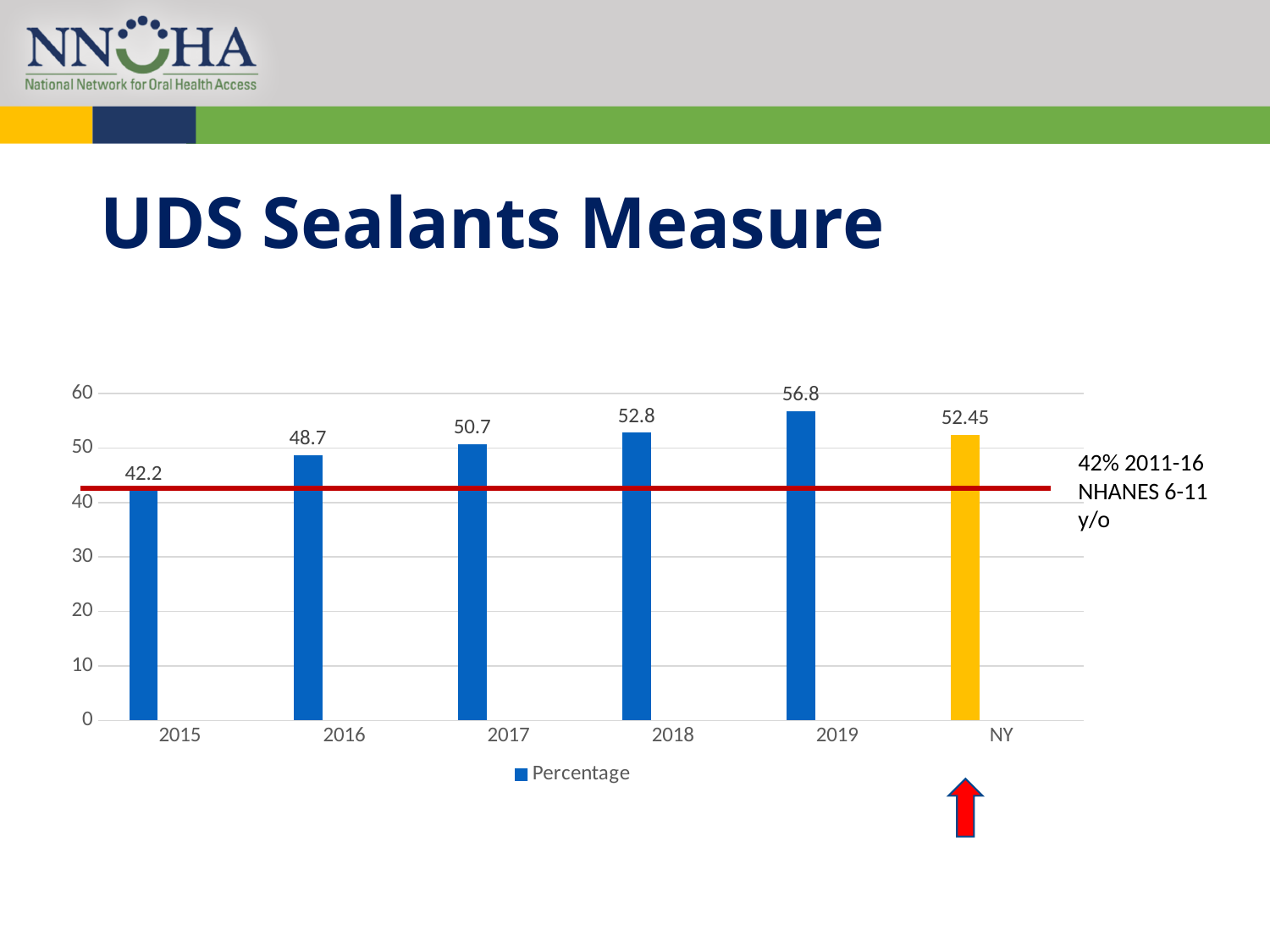
What is the value for 2019? 56.8 Which category has the highest value? 2019 How many bars are shown in the chart? 6 What is the difference between the values for 2019 and 2015? 14.6 Which is larger, the value for 2018 or the value for NY? 2018 Which category has the lowest value? 2015 What is the value for NY? 52.45 Is the value for 2016 greater or less than 50? less Do the values rise or fall from 2015 to 2019? rise What kind of chart is shown on the slide? bar chart What is the value for 2015? 42.2 How many series does the legend list? 1